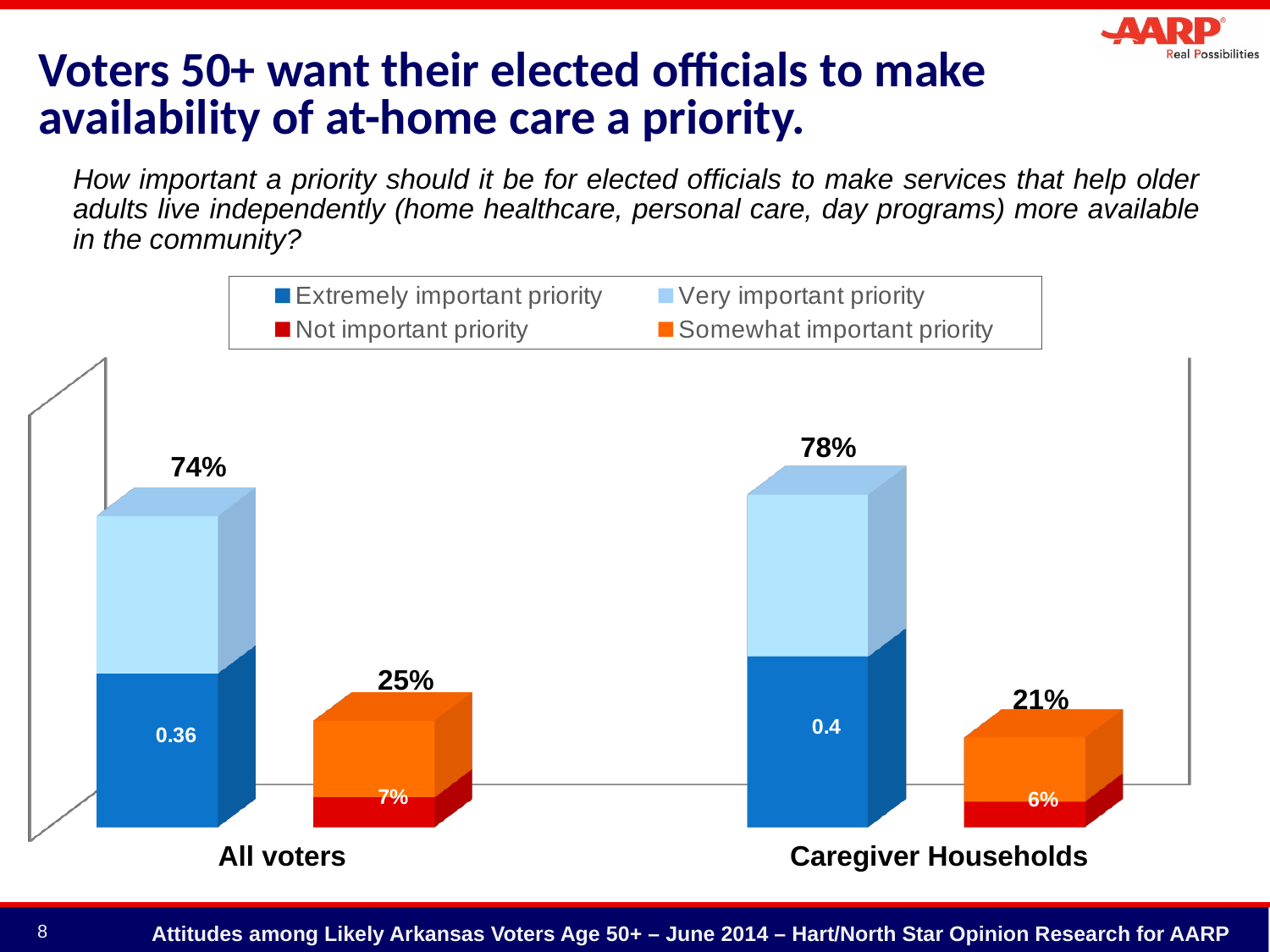
How many series does the chart legend list? 4 What value is printed on the Not important priority segment for All voters? 7% What total is printed above the orange stacked bar (Somewhat plus Not important priority) for Caregiver Households? 21% How many categories are shown along the x axis of the chart? 2 What total is printed above the blue stacked bar (Extremely plus Very important priority) for All voters? 74% What is the difference between the 78% total for Caregiver Households and the 74% total for All voters? 4 percentage points Is the Not important priority value larger for All voters or for Caregiver Households? All voters What total is printed above the blue stacked bar (Extremely plus Very important priority) for Caregiver Households? 78% What value is printed on the Extremely important priority segment for All voters? 0.36 What kind of chart is shown on the slide? Stacked bar chart What value is printed on the Not important priority segment for Caregiver Households? 6% What value is printed on the Extremely important priority segment for Caregiver Households? 0.4